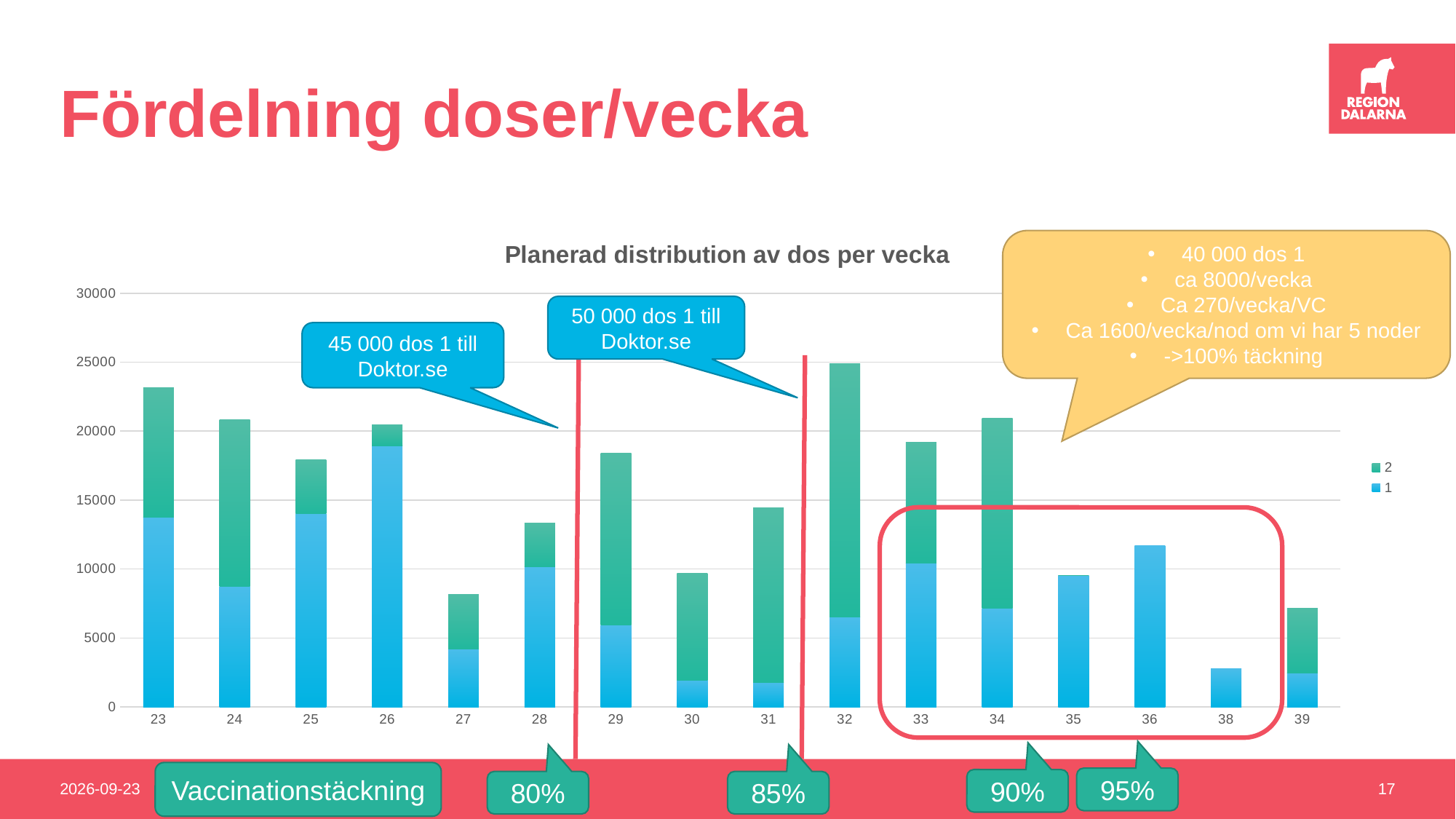
What are the entries in the chart legend? 2 and 1 Is the series 1 value for week 26 greater or less than 15000? greater Is the total bar for week 27 greater or less than 10000? less What kind of chart is shown on the slide? Stacked bar chart Which week has the larger total bar, week 29 or week 30? 29 Which week has the highest total bar in the chart? 32 How many series does the chart legend list? 2 What is the title of the chart? Planerad distribution av dos per vecka Is the total bar for week 38 greater or less than 5000? less How many weeks (categories) are shown on the x axis of the chart? 16 Which week has the lowest total bar in the chart? 38